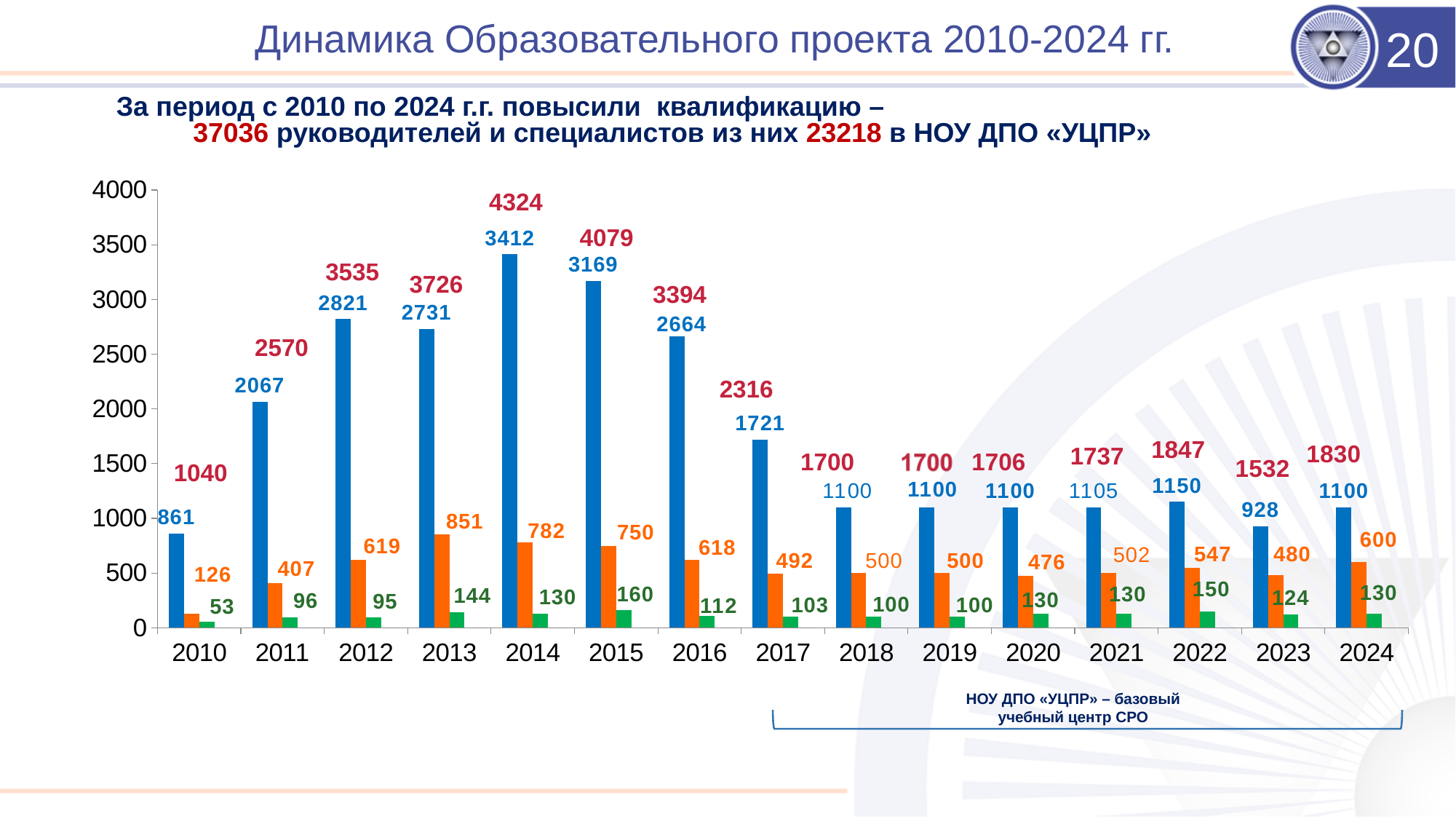
What is the value of the orange bar for 2013? 851 Is the blue bar for 2023 greater or less than 1000? less In which year is the blue bar the lowest? 2010 What is the difference between the blue bar values for 2014 and 2015? 243 What type of chart is shown on the slide? bar chart What is the red total figure printed above the bars for 2022? 1847 How many years are shown on the x axis of the chart? 15 What is the value of the green bar for 2015? 160 What is the value of the blue bar for 2014? 3412 What is the title of the slide containing the chart? Динамика Образовательного проекта 2010-2024 гг. Which is larger, the orange bar for 2012 or the orange bar for 2016? 2012 In which year is the blue bar the highest? 2014